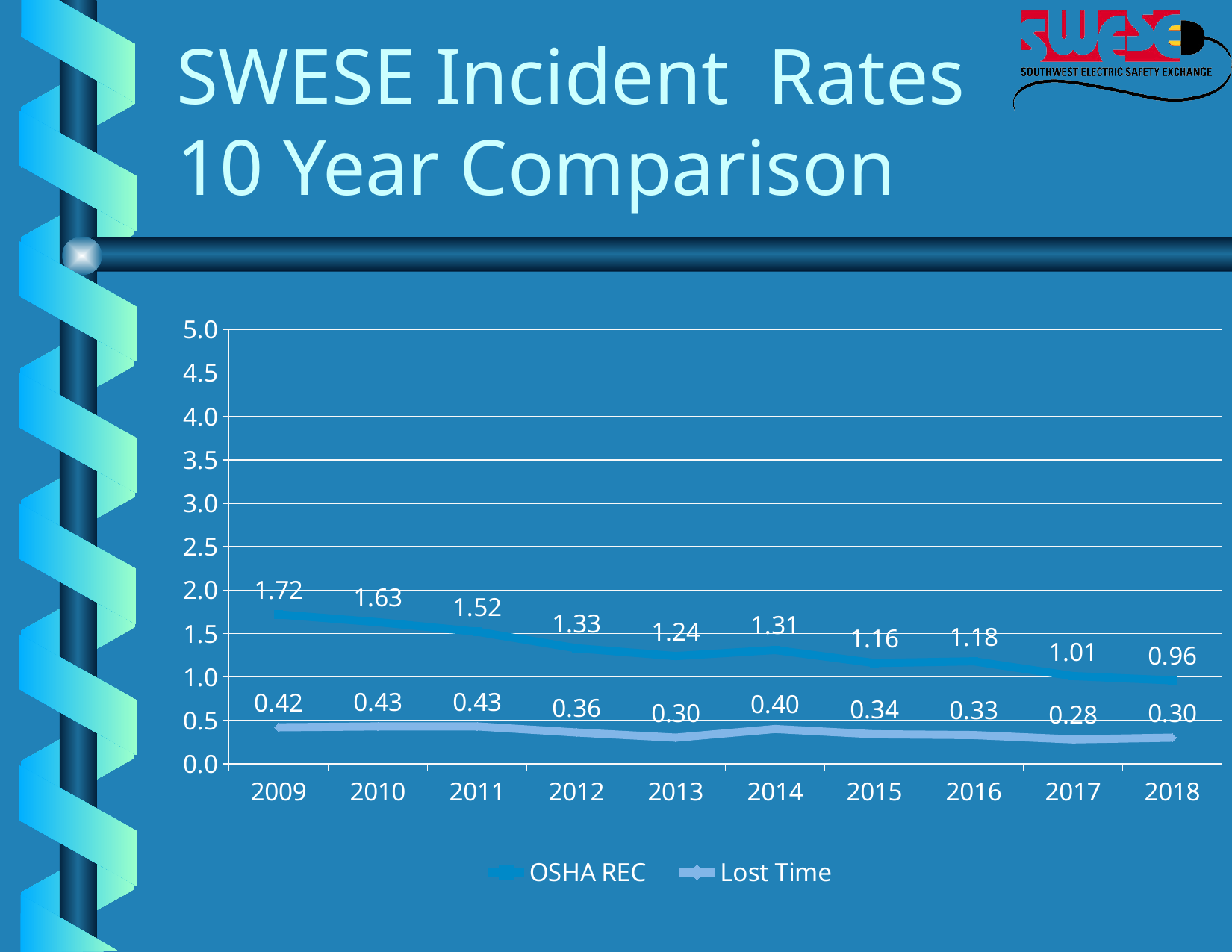
What is the Lost Time value for 2014? 0.40 Does the OSHA REC series generally rise or fall from 2009 to 2018? fall What kind of chart is shown on the slide? line chart Is the OSHA REC value for 2012 greater or less than 1.0? greater Which year has the lowest Lost Time value? 2017 What is the difference between the OSHA REC values for 2009 and 2018? 0.76 Which year has the highest OSHA REC value? 2009 How many years are shown on the x axis? 10 What is the OSHA REC value for 2018? 0.96 How many series does the legend list? 2 What is the OSHA REC value for 2009? 1.72 Which is larger, the Lost Time value for 2013 or for 2014? 2014